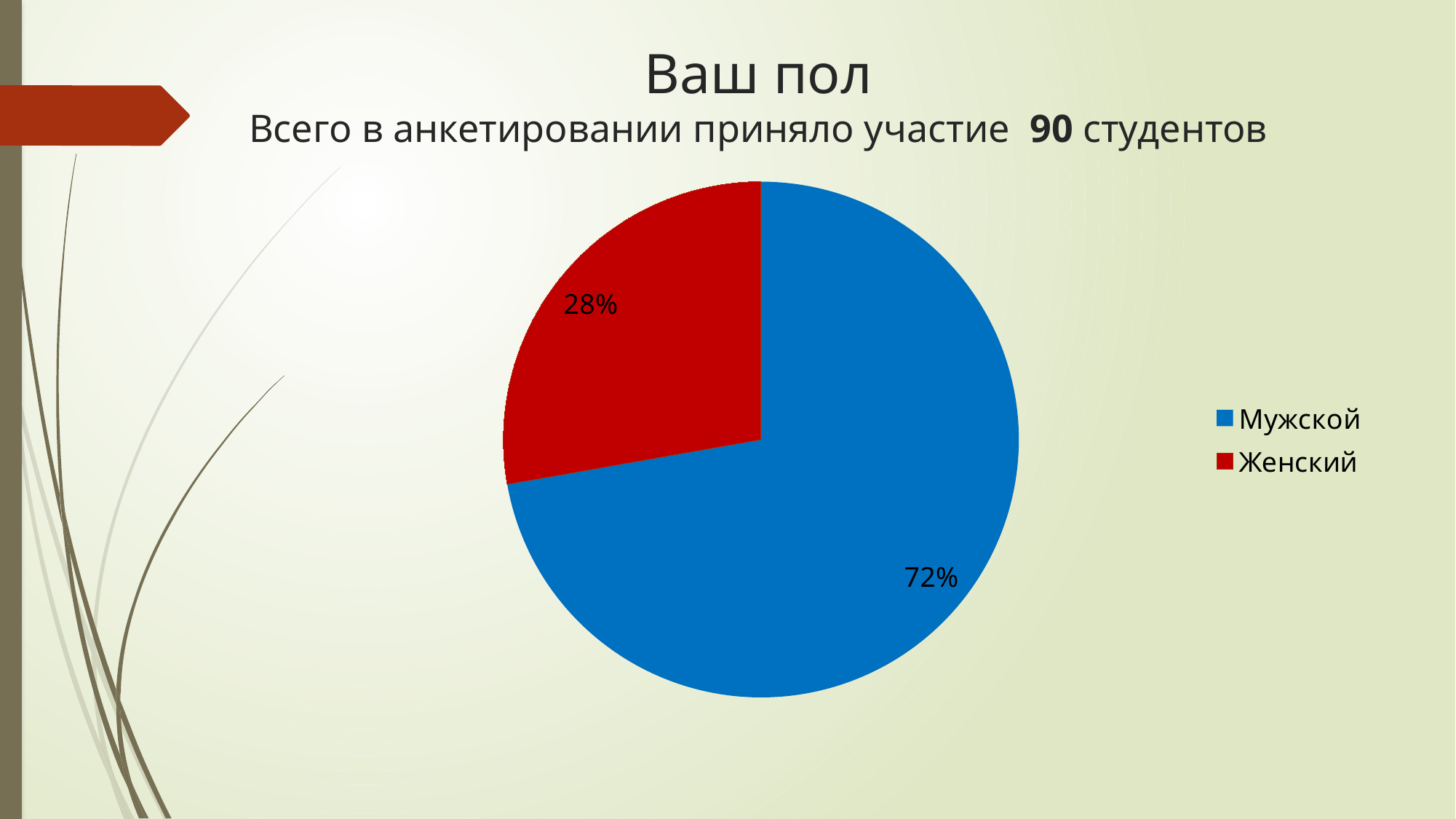
Which category has the largest slice of the pie? Мужской What percentage of the pie is labelled for Мужской? 72% What colour is the Мужской slice? blue What share of the pie does the Женский slice represent? 28% Which category has the smallest slice of the pie? Женский How many slices does the pie chart have? 2 Which slice is larger, Мужской or Женский? Мужской What kind of chart is shown on the slide? pie chart According to the slide subtitle, how many students took part in the survey? 90 What percentage of the pie is labelled for Женский? 28% What is the difference in percentage points between the Мужской and Женский slices? 44 How many entries does the legend list? 2